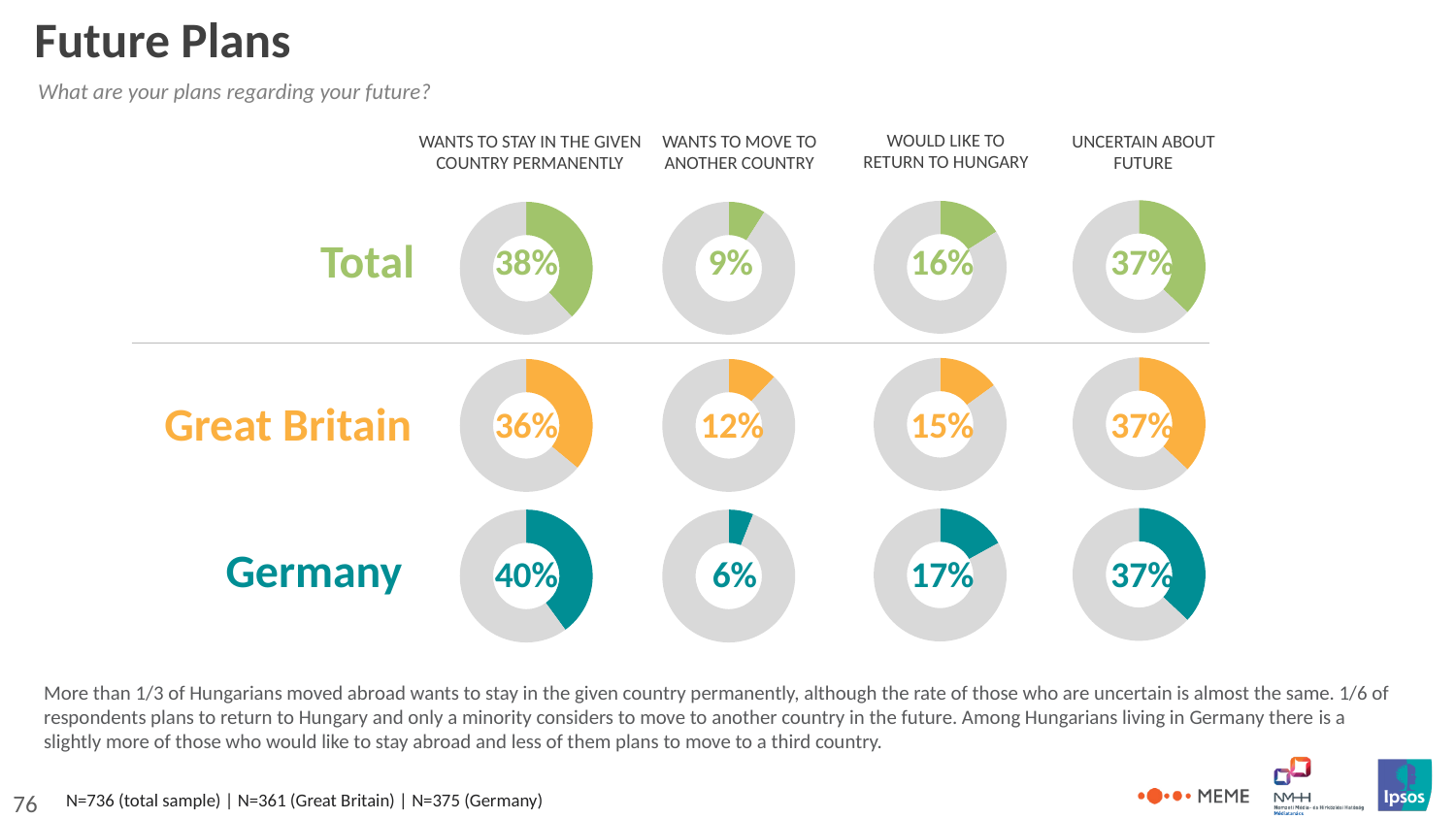
In the Total row, which is larger: the share that wants to stay permanently or the share that is uncertain about the future? Wants to stay in the given country permanently How many donut charts are shown on the slide? 12 What colour are the donut chart segments in the Great Britain row? Orange In the Germany row, what percentage wants to move to another country? 6% In the Great Britain row, what percentage would like to return to Hungary? 15% What is the difference between Great Britain and Germany in the 'Wants to move to another country' column? 6% In the Germany row, what percentage is uncertain about the future? 37% What type of chart is used to show each value on the slide? Donut chart What is the difference between Germany and Total in the 'Would like to return to Hungary' column? 1% Across the 'Wants to move to another country' column, which group has the lowest percentage? Germany In the Total row, what percentage wants to stay in the given country permanently? 38% Across the 'Wants to stay in the given country permanently' column, which group has the highest percentage? Germany